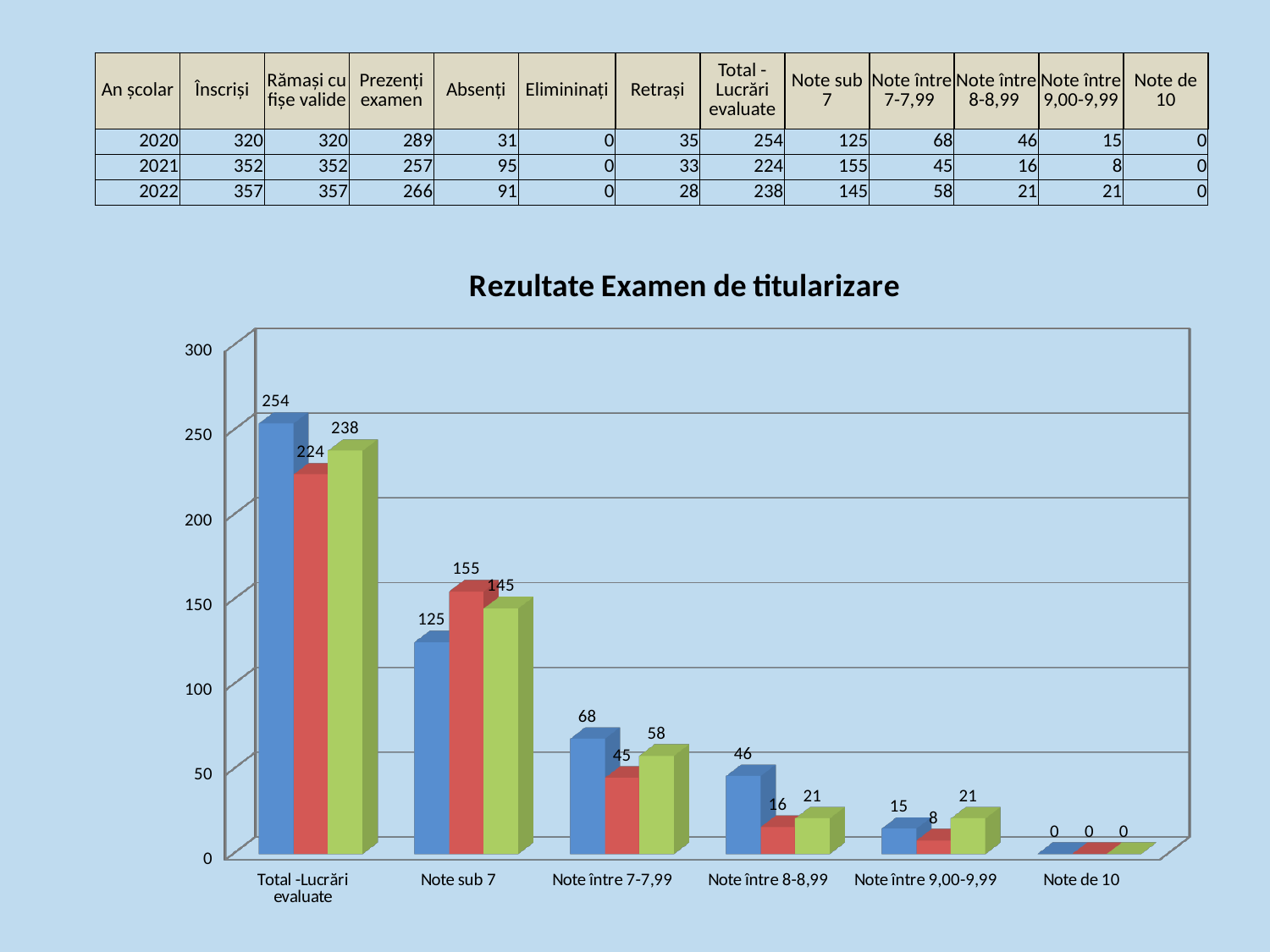
What is the difference between the blue bar and the red bar for 'Note între 8-8,99'? 30 Which category has the lowest values across all three bars? Note de 10 How many categories are shown on the x axis of the chart? 6 Is the value of the green bar for 'Total -Lucrări evaluate' greater or less than 200? greater What type of chart is shown on the slide? bar chart Which is larger for 'Note sub 7': the blue bar or the green bar? the green bar What is the value of the green bar for 'Note între 7-7,99'? 58 What is the value of the red bar for 'Note între 9,00-9,99'? 8 What is the value of the blue bar for 'Total -Lucrări evaluate'? 254 What is the value of the red bar for 'Note sub 7'? 155 What is the title of the chart? Rezultate Examen de titularizare Which category has the highest blue bar? Total -Lucrări evaluate